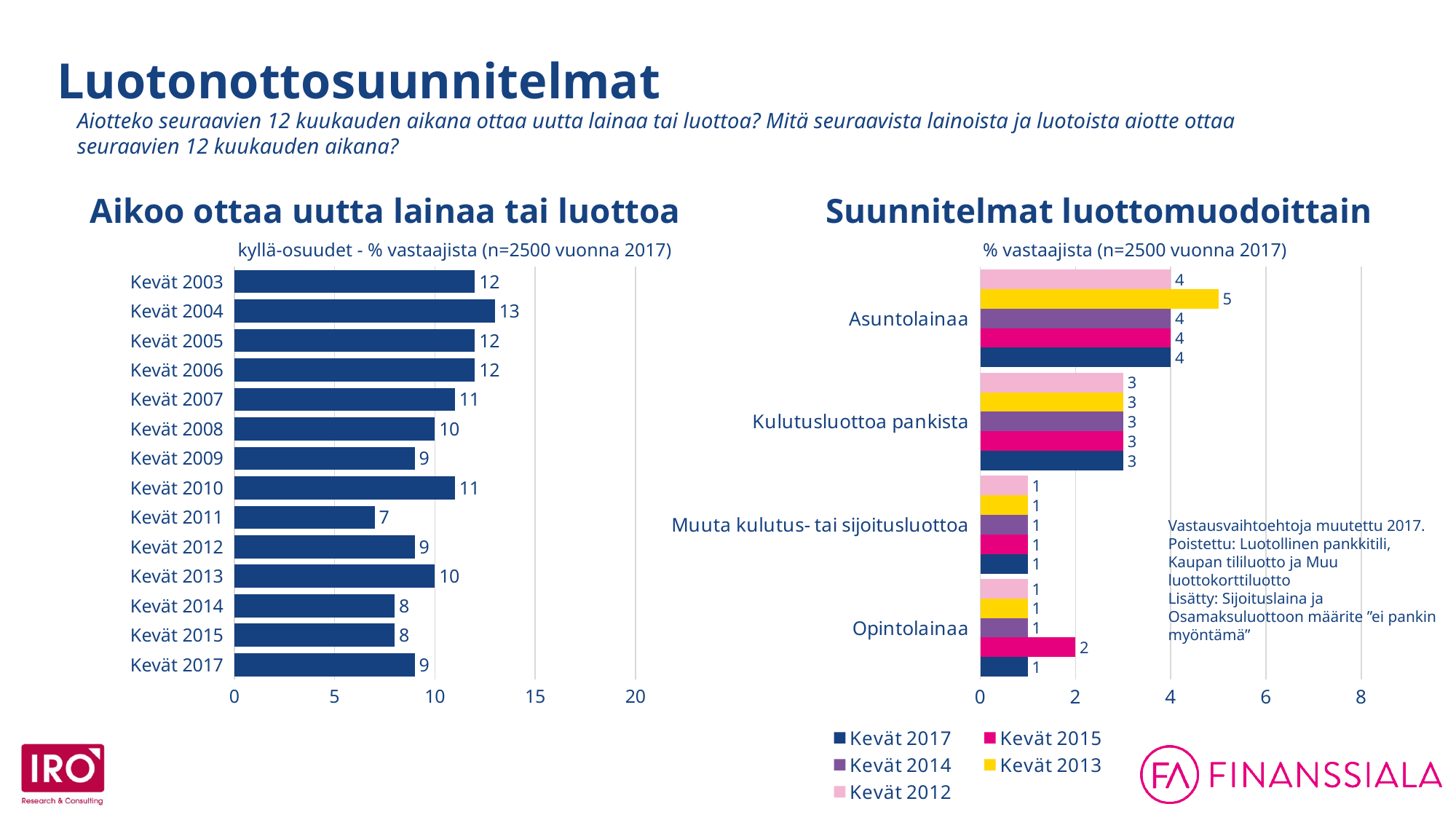
In the chart 'Aikoo ottaa uutta lainaa tai luottoa', which year has the lowest value? Kevät 2011 In the chart 'Suunnitelmat luottomuodoittain', what is the difference between the Kevät 2013 value for Asuntolainaa and the Kevät 2013 value for Kulutusluottoa pankista? 2 In the chart 'Aikoo ottaa uutta lainaa tai luottoa', what is the difference between the values for Kevät 2004 and Kevät 2011? 6 How many series does the legend of the chart 'Suunnitelmat luottomuodoittain' list? 5 How many loan categories are shown in the chart 'Suunnitelmat luottomuodoittain'? 4 In the chart 'Aikoo ottaa uutta lainaa tai luottoa', which is larger, the value for Kevät 2010 or Kevät 2017? Kevät 2010 In the chart 'Suunnitelmat luottomuodoittain', what is the value for Asuntolainaa in Kevät 2013? 5 How many years are shown in the chart 'Aikoo ottaa uutta lainaa tai luottoa'? 14 In the chart 'Aikoo ottaa uutta lainaa tai luottoa', what is the value for Kevät 2004? 13 What type of chart is 'Aikoo ottaa uutta lainaa tai luottoa'? Bar chart In the chart 'Aikoo ottaa uutta lainaa tai luottoa', which year has the highest value? Kevät 2004 In the chart 'Suunnitelmat luottomuodoittain', what is the value for Opintolainaa in Kevät 2015? 2